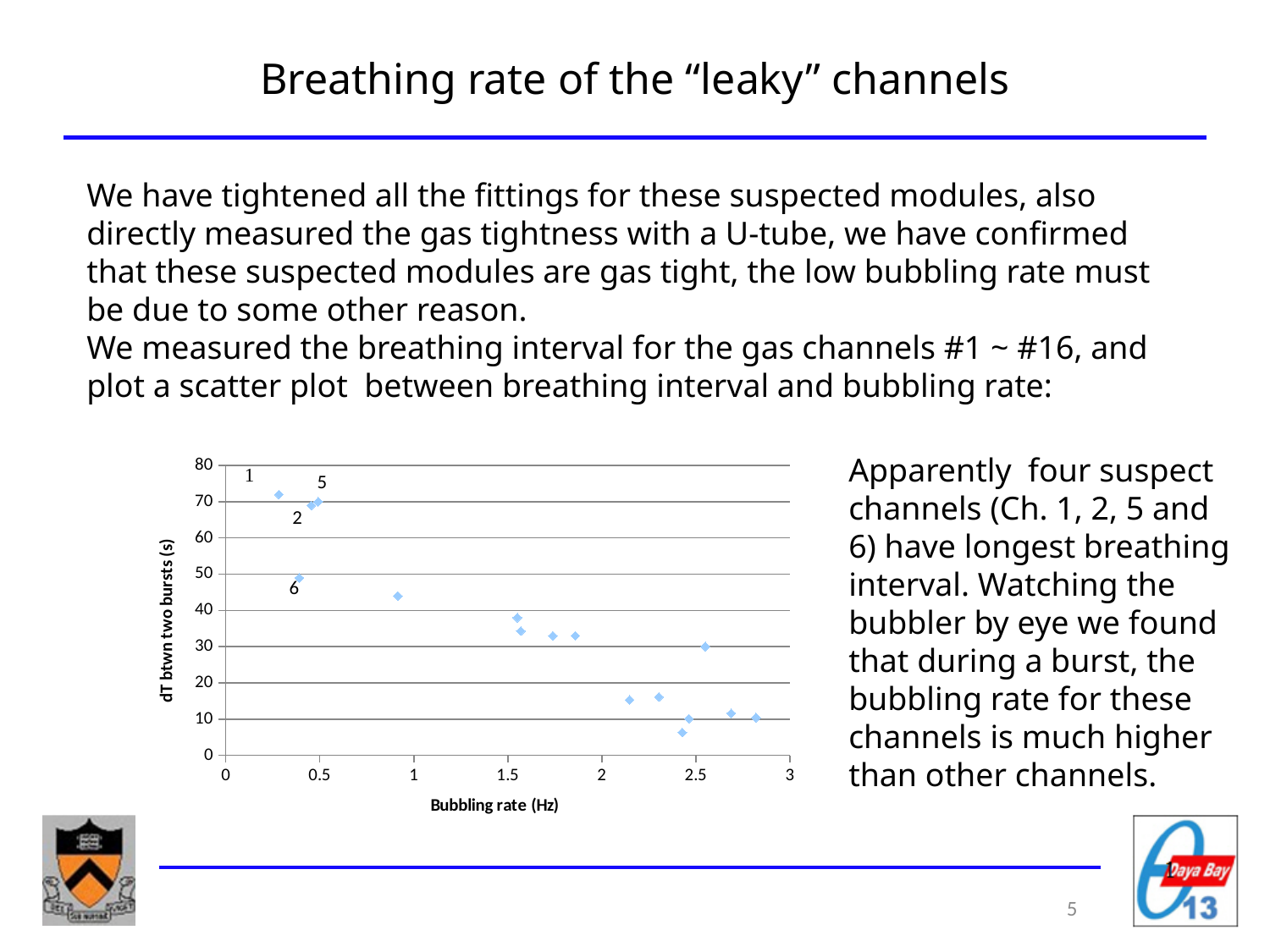
As the bubbling rate increases along the x axis, does the time between bursts generally rise or fall? fall Is the dT value for the point labelled 6 greater or less than 60? less What is the label of the y axis of the chart? dT btwn two bursts (s) Is the dT value for the point labelled 5 greater or less than 60? greater Are the points with bubbling rate above 2 Hz mostly greater or less than 40 s in dT? less Which has a larger dT between two bursts: the point labelled 2 or the point labelled 6? 2 What is the label of the x axis of the chart? Bubbling rate (Hz) What is the maximum value shown on the y axis of the chart? 80 What kind of chart is shown on the slide? scatter plot Which labelled point on the chart has the highest dT between two bursts? 1